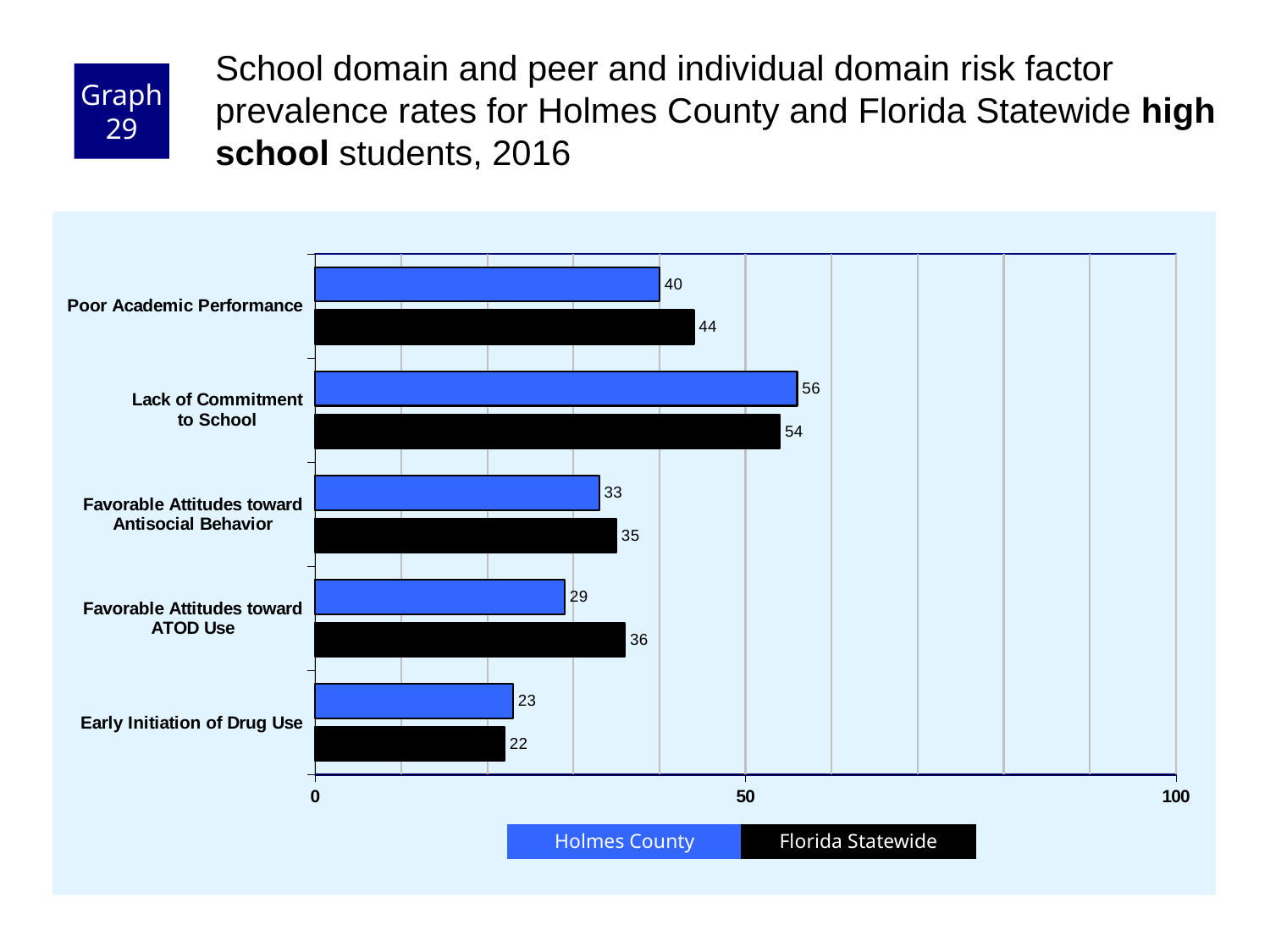
Which risk factor has the lowest Florida Statewide value? Early Initiation of Drug Use What is the difference between the Florida Statewide and Holmes County values for Favorable Attitudes toward ATOD Use? 7 What is the Holmes County value for Poor Academic Performance? 40 What is the Holmes County value for Early Initiation of Drug Use? 23 What is the Florida Statewide value for Favorable Attitudes toward ATOD Use? 36 For Lack of Commitment to School, which is larger: the Holmes County value or the Florida Statewide value? Holmes County Which risk factor has the highest Holmes County value? Lack of Commitment to School Is the Florida Statewide value for Lack of Commitment to School greater or less than 50? greater What kind of chart is shown on the slide? Bar chart Which colour represents Florida Statewide in the chart? Black How many risk factor categories are shown on the chart? 5 How many series does the legend list? 2